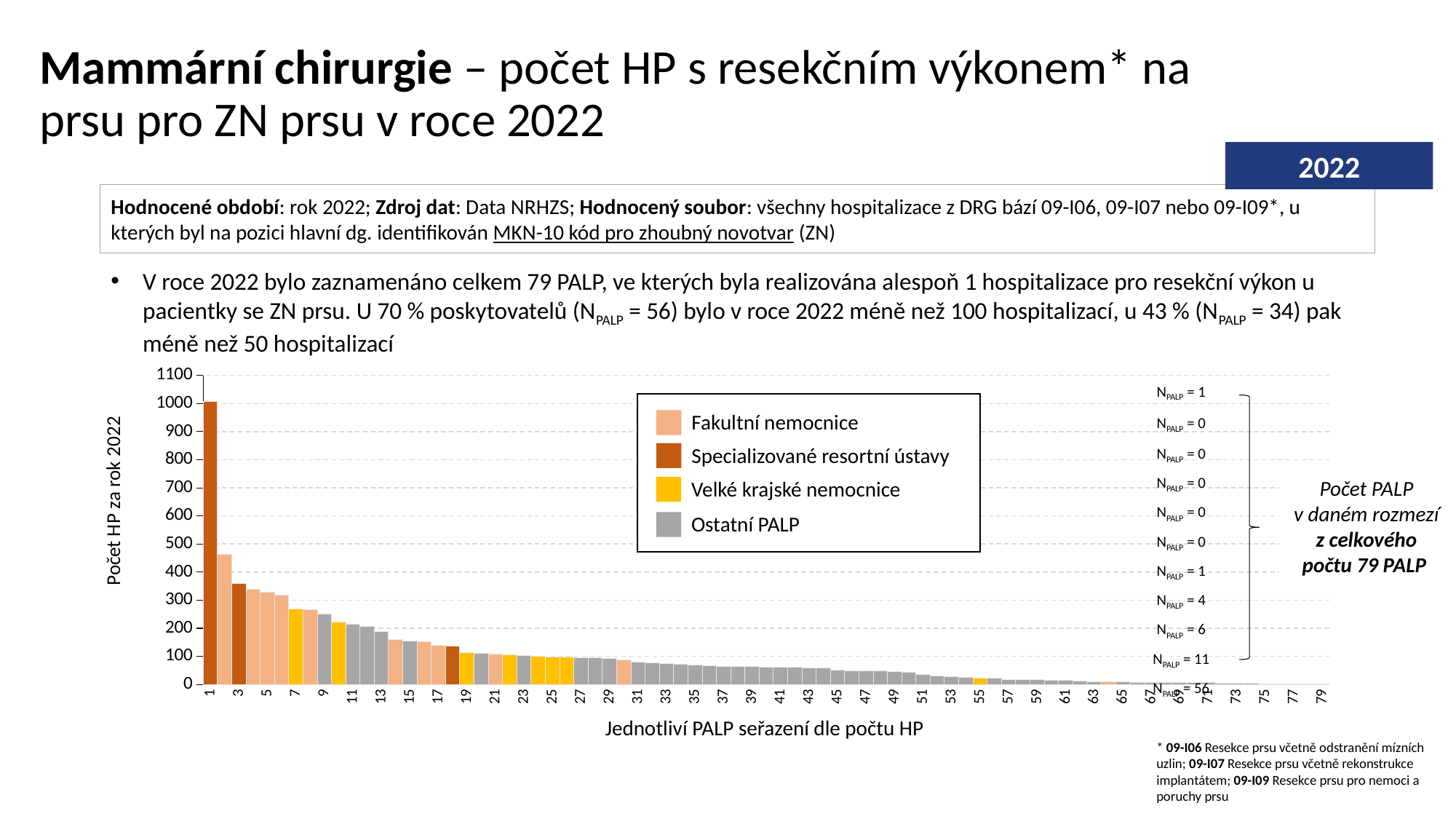
How many PALP (bars) are plotted along the x axis of the chart? 79 Is the value for PALP 2 greater or less than 400? greater Which has a larger value, PALP 1 or PALP 2? PALP 1 Is the value for PALP 10 greater or less than 300? less What colour represents 'Velké krajské nemocnice' in the chart legend? yellow How many entries does the chart legend list? 4 What is the label of the y axis of the chart? Počet HP za rok 2022 Which PALP (x-axis position) has the highest number of HP in the chart? 1 What kind of chart is shown on the slide? bar chart Is the value for PALP 40 greater or less than 100? less Do the bar values rise or fall from left to right along the x axis? fall